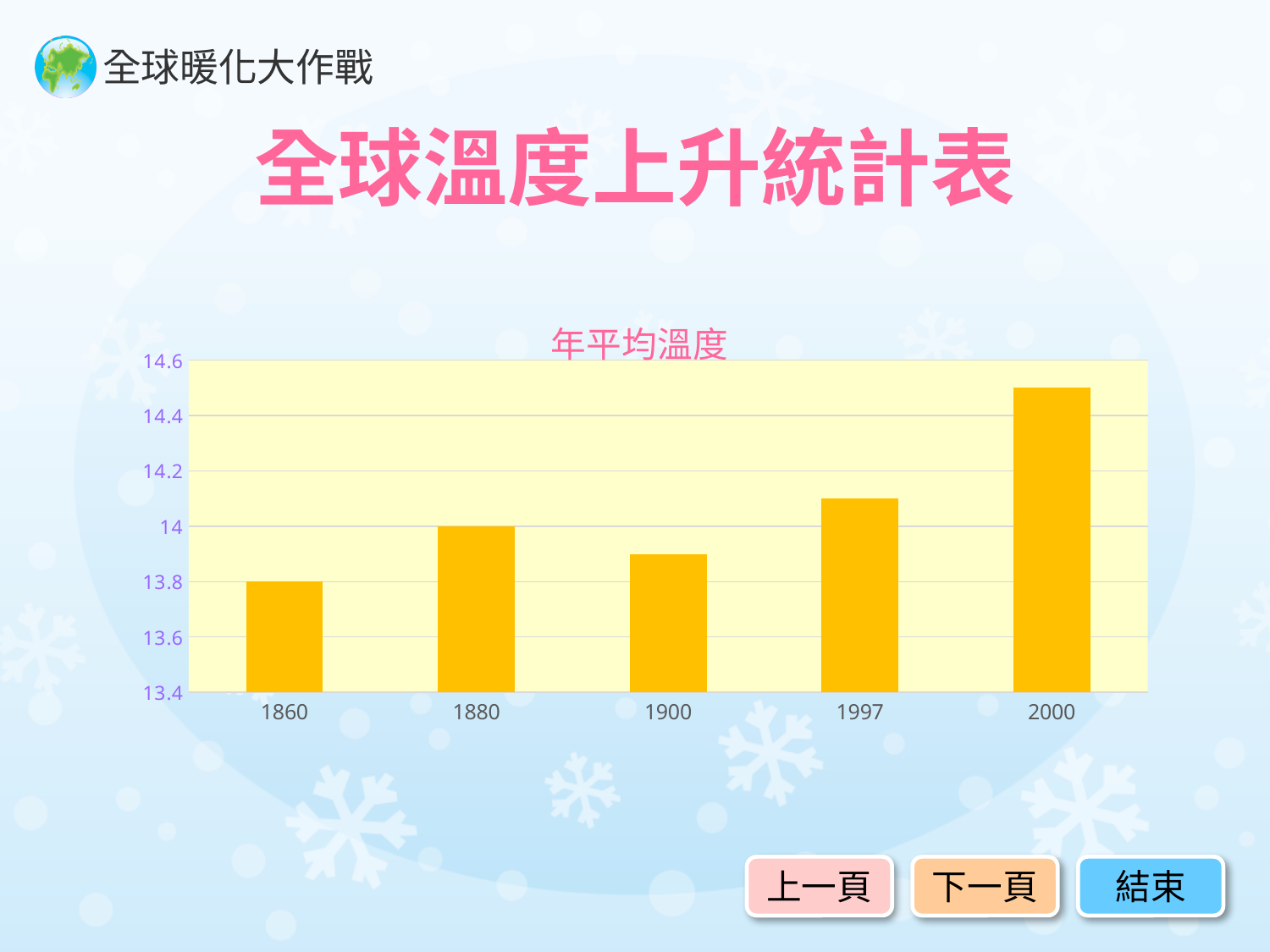
What is the difference between the values for 1880 and 1860? 0.2 Which year has the lowest value? 1860 What is the title of the chart? 年平均溫度 Which is larger, the value for 1997 or the value for 1900? 1997 Is the value for 2000 greater or less than 14.4? greater What is the value for 1860? 13.8 Between 1997 and 2000, does the value rise or fall? rise What type of chart is shown on the slide? bar chart Which year has the highest value? 2000 What is the value for 1880? 14 How many years (categories) are plotted on the x axis? 5 Is the value for 1900 greater or less than 14? less